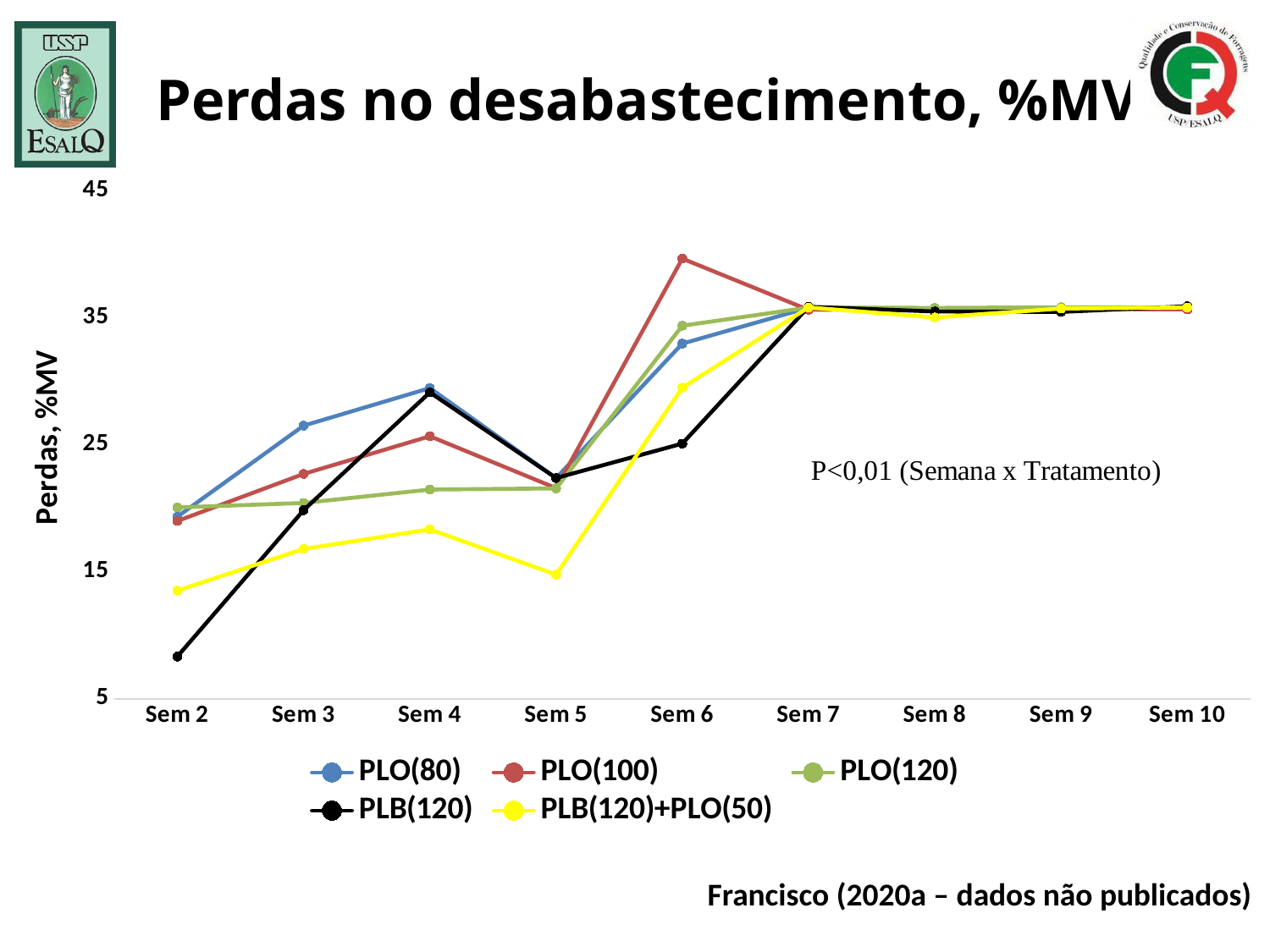
Is the value for PLB(120) at Sem 2 greater or less than 15? less Does the PLB(120) series rise or fall overall from Sem 2 to Sem 7? rise Is the value for PLO(120) at Sem 5 greater or less than 25? less How many weeks (categories) are shown on the x axis? 9 What is the label of the y axis? Perdas, %MV What kind of chart is shown on the slide? line chart How many series does the legend list? 5 Which series has the lowest value at Sem 2? PLB(120) Which series has the highest value at Sem 6? PLO(100) Is the value for PLO(100) at Sem 6 greater or less than 35? greater Which series has the lowest value at Sem 5? PLB(120)+PLO(50) At Sem 3, which is larger: PLO(80) or PLB(120)+PLO(50)? PLO(80)